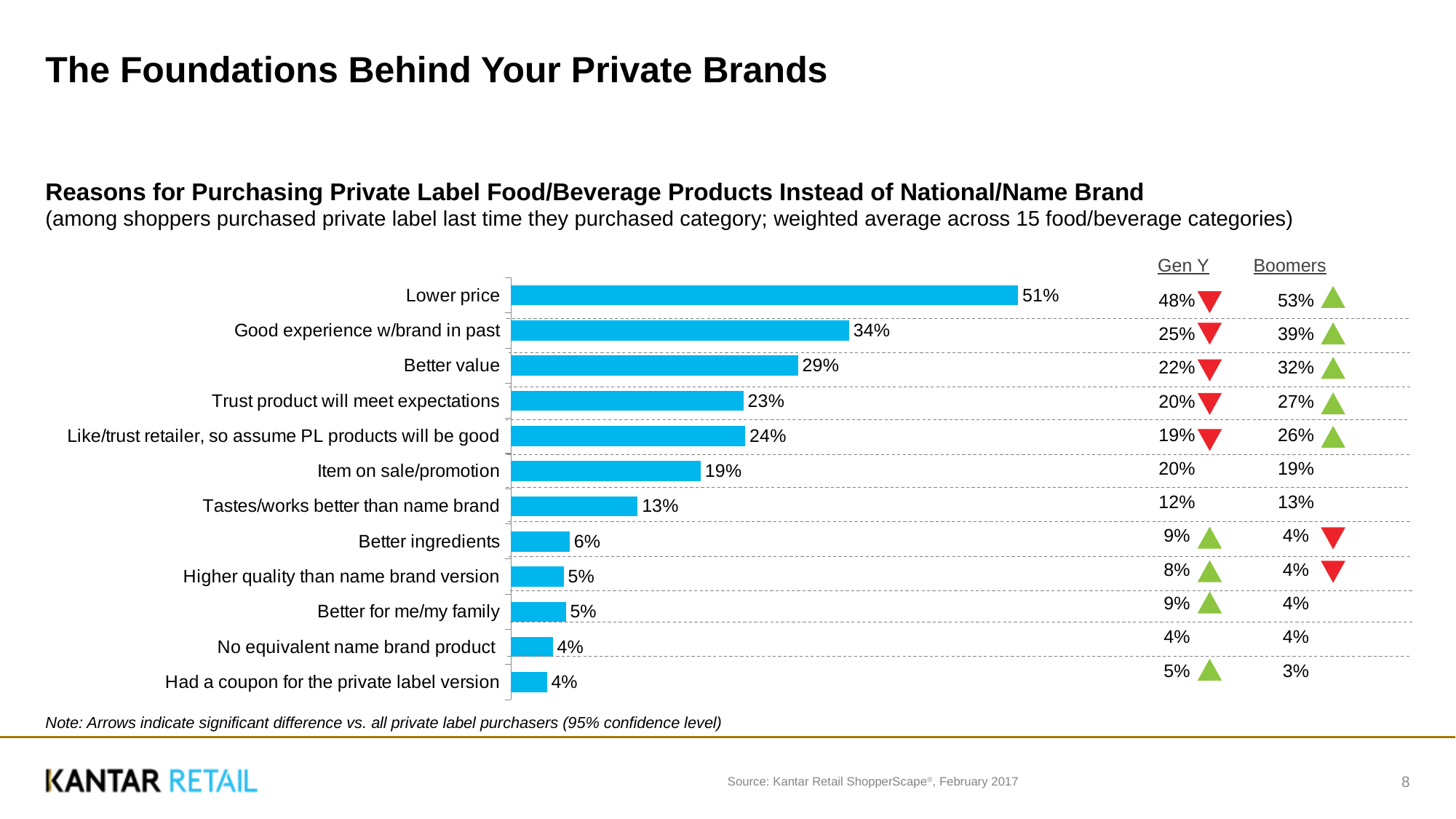
What kind of chart is used to show the reasons for purchasing private label? Bar chart Which is larger: the value for "Better value" or the value for "Trust product will meet expectations"? Better value Which reason has the highest percentage in the chart? Lower price How many reasons (categories) are plotted in the bar chart? 12 What percentage of shoppers cited "Lower price" as a reason for purchasing private label? 51% What is the value shown for "Item on sale/promotion"? 19% Do the bar values generally rise or fall going from the top category to the bottom category? Fall What is the difference between the values for "Lower price" and "Good experience w/brand in past"? 17% What is the value shown for "Better ingredients"? 6% What is the difference between the values for "Like/trust retailer, so assume PL products will be good" and "Trust product will meet expectations"? 1% What is the value shown for "Good experience w/brand in past"? 34% What colour are the bars in the chart? Blue